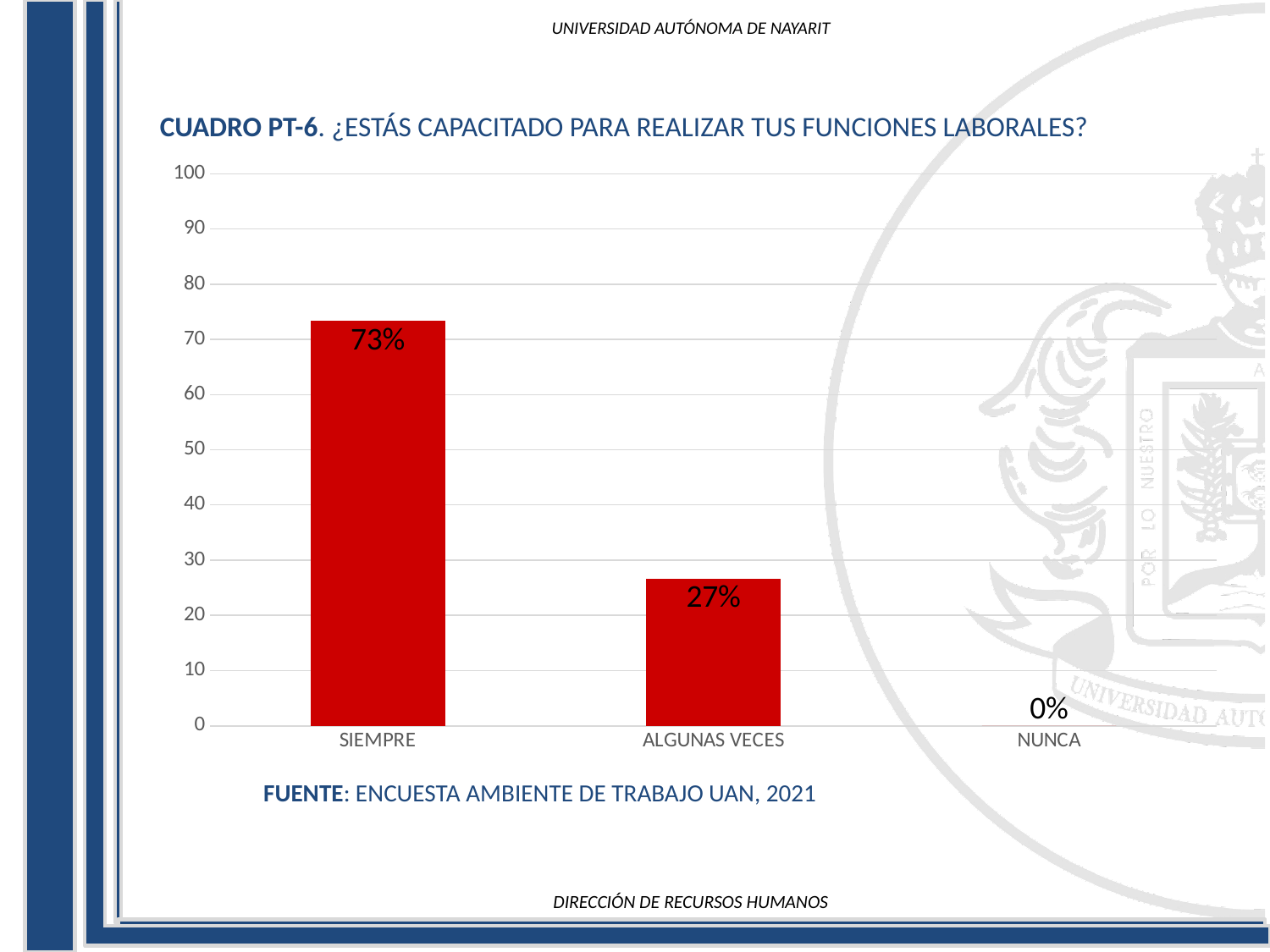
Is the value for SIEMPRE greater or less than 50? greater How many categories are shown on the x axis? 3 What kind of chart is shown on the slide? bar chart Which category has the lowest value? NUNCA What is the value for SIEMPRE? 73% What is the difference between the values for SIEMPRE and ALGUNAS VECES? 46% Is the value for ALGUNAS VECES greater or less than 30? less Which category has the highest value? SIEMPRE What is the value for ALGUNAS VECES? 27% What is the value for NUNCA? 0% Which is larger, the value for ALGUNAS VECES or the value for NUNCA? ALGUNAS VECES What is the source cited below the chart? ENCUESTA AMBIENTE DE TRABAJO UAN, 2021